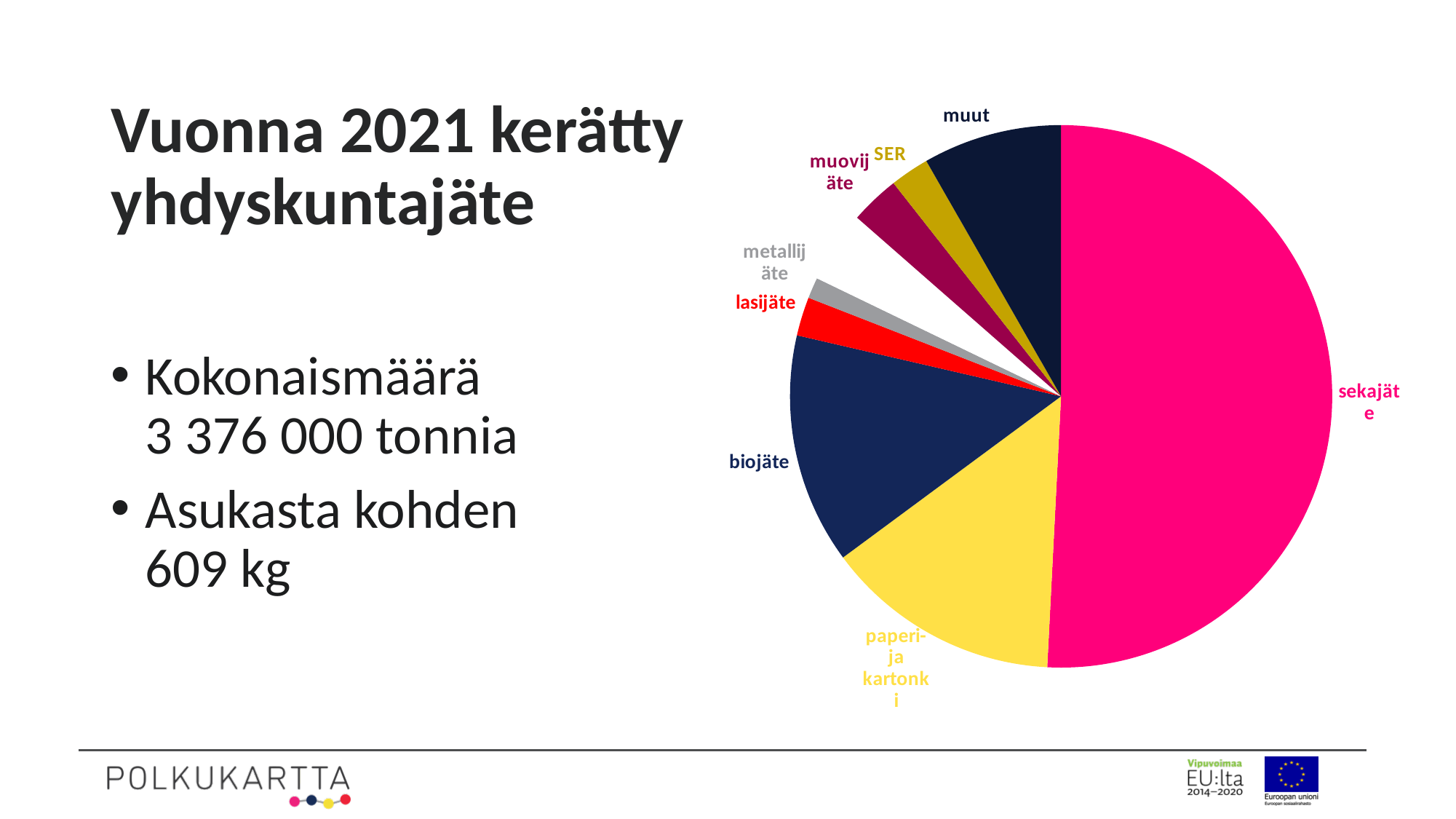
Which slice is larger, muut or lasijäte? muut What kind of chart is shown on the slide? pie chart What colour is the paperi- ja kartonki slice in the pie chart? yellow Which category has the smallest slice in the pie chart? metallijäte Which slice is larger, sekajäte or paperi- ja kartonki? sekajäte How many slices does the pie chart have? 9 What colour is the sekajäte slice in the pie chart? pink Which slice is larger, biojäte or muovijäte? biojäte Which category has the largest slice in the pie chart? sekajäte